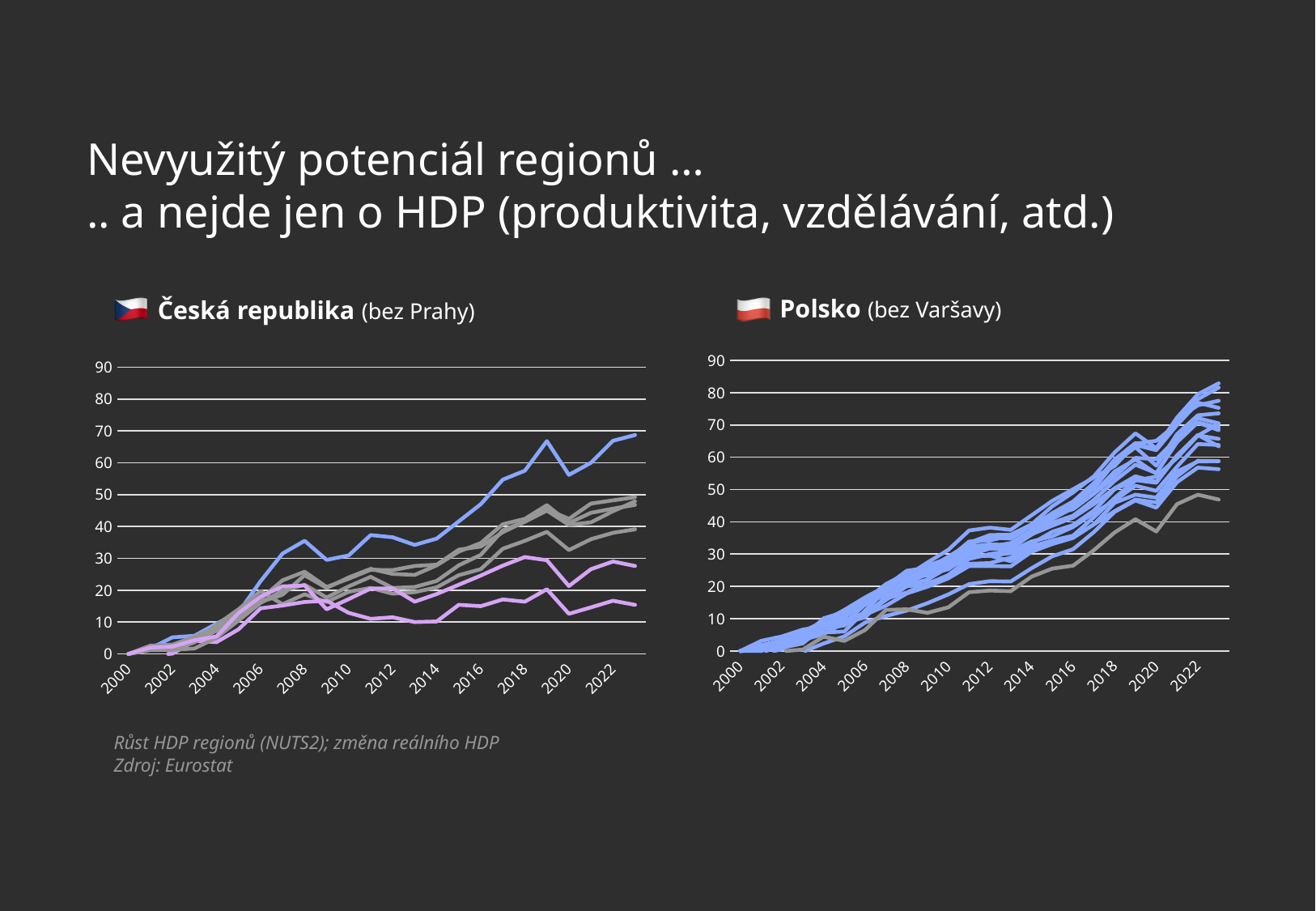
What kind of chart is the "Česká republika (bez Prahy)" chart? line chart What is the highest value shown on the y axis of the "Polsko (bez Varšavy)" chart? 90 What source is cited for the charts on the slide? Eurostat How many year labels are shown on the x axis of the "Česká republika (bez Prahy)" chart? 12 What kind of chart is the "Polsko (bez Varšavy)" chart? line chart In the "Česká republika (bez Prahy)" chart, is the value of the highest line in 2022 greater or less than 60? greater In the "Polsko (bez Varšavy)" chart, do the values generally rise or fall from 2000 to 2022? rise In the "Česká republika (bez Prahy)" chart, is the value of the lowest line in 2022 greater or less than 20? less Which chart reaches a higher maximum value by 2022, "Česká republika (bez Prahy)" or "Polsko (bez Varšavy)"? Polsko (bez Varšavy) In the "Polsko (bez Varšavy)" chart, is the value of the lowest (grey) line in 2022 greater or less than 50? less